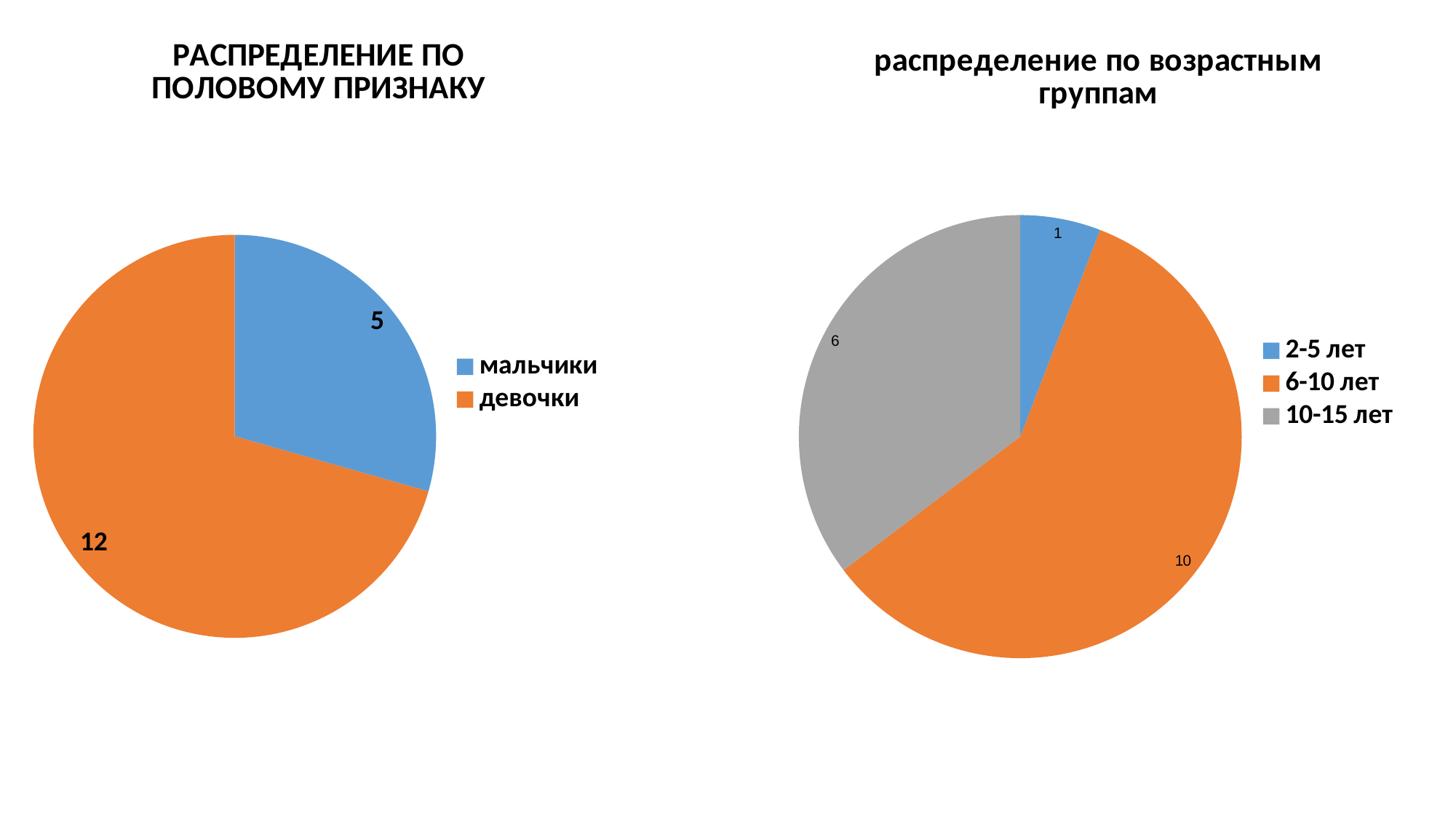
In the left chart (РАСПРЕДЕЛЕНИЕ ПО ПОЛОВОМУ ПРИЗНАКУ), what kind of chart is shown? pie chart In the left chart (РАСПРЕДЕЛЕНИЕ ПО ПОЛОВОМУ ПРИЗНАКУ), how many categories does the legend list? 2 In the left chart (РАСПРЕДЕЛЕНИЕ ПО ПОЛОВОМУ ПРИЗНАКУ), which category has the larger value? девочки In the right chart (распределение по возрастным группам), what is the value for 10-15 лет? 6 In the left chart (РАСПРЕДЕЛЕНИЕ ПО ПОЛОВОМУ ПРИЗНАКУ), what is the value for мальчики? 5 In the right chart (распределение по возрастным группам), how many age groups are shown? 3 In the right chart (распределение по возрастным группам), what is the value for 6-10 лет? 10 In the right chart (распределение по возрастным группам), which is larger, 6-10 лет or 10-15 лет? 6-10 лет In the left chart (РАСПРЕДЕЛЕНИЕ ПО ПОЛОВОМУ ПРИЗНАКУ), what is the value for девочки? 12 In the right chart (распределение по возрастным группам), which age group has the smallest value? 2-5 лет In the right chart (распределение по возрастным группам), what is the value for 2-5 лет? 1 In the left chart (РАСПРЕДЕЛЕНИЕ ПО ПОЛОВОМУ ПРИЗНАКУ), what is the difference between девочки and мальчики? 7